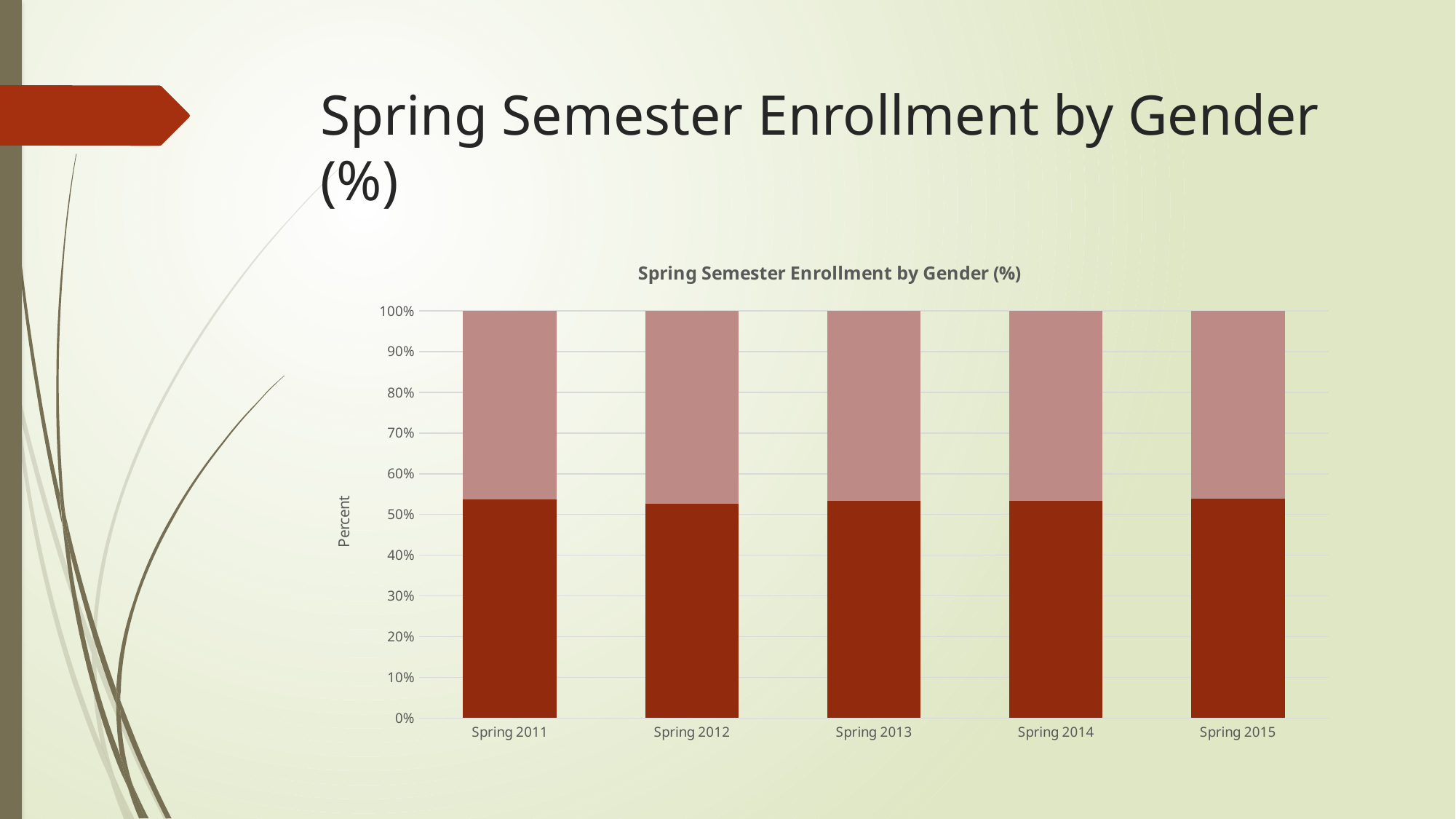
How many semesters are shown on the x axis of the chart? 5 Is the dark red segment for Spring 2014 greater or less than 40%? greater What is the label on the vertical axis of the chart? Percent What is the highest value shown on the vertical axis of the chart? 100% Is the dark red segment for Spring 2011 greater or less than 50%? greater What is the title of the chart? Spring Semester Enrollment by Gender (%) Is the dark red segment for Spring 2012 greater or less than 60%? less Which is larger in Spring 2013, the dark red segment or the light pink segment? the dark red segment What is the total height of the stacked bar for Spring 2013? 100% What kind of chart is shown on the slide? Stacked bar chart